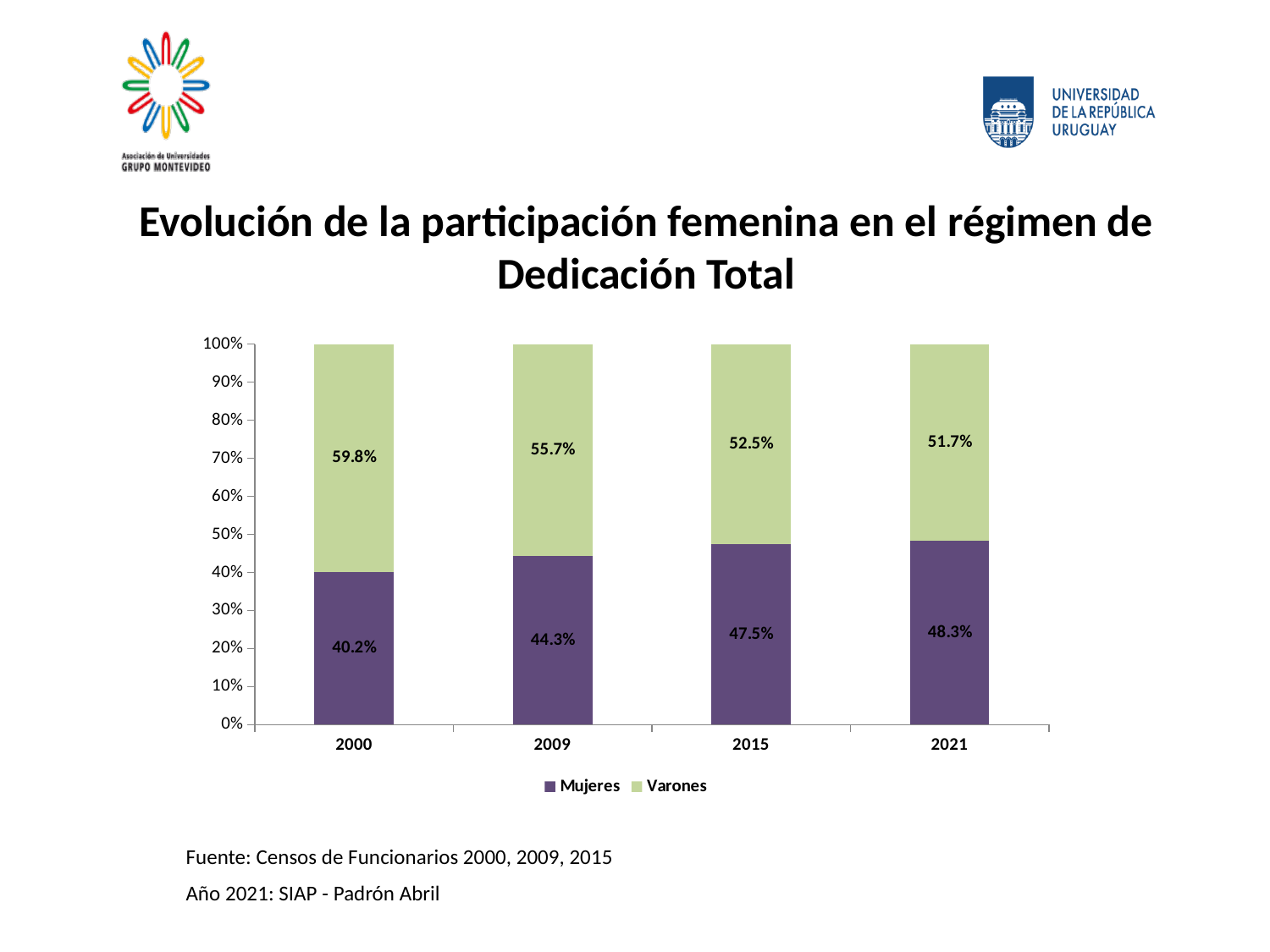
In which year is the Mujeres share highest? 2021 What kind of chart is shown? Stacked bar chart Is the value for Mujeres in 2000 greater or less than 50%? less How many years are shown on the x axis? 4 How many series does the legend list? 2 Which is larger in 2015, the Mujeres share or the Varones share? Varones What is the value for Mujeres in 2015? 47.5% What is the difference between the Varones and Mujeres shares in 2009? 11.4% What is the value for Mujeres in 2000? 40.2% Does the Mujeres share rise or fall from 2000 to 2021? Rise In which year is the Varones share lowest? 2021 What is the value for Varones in 2021? 51.7%